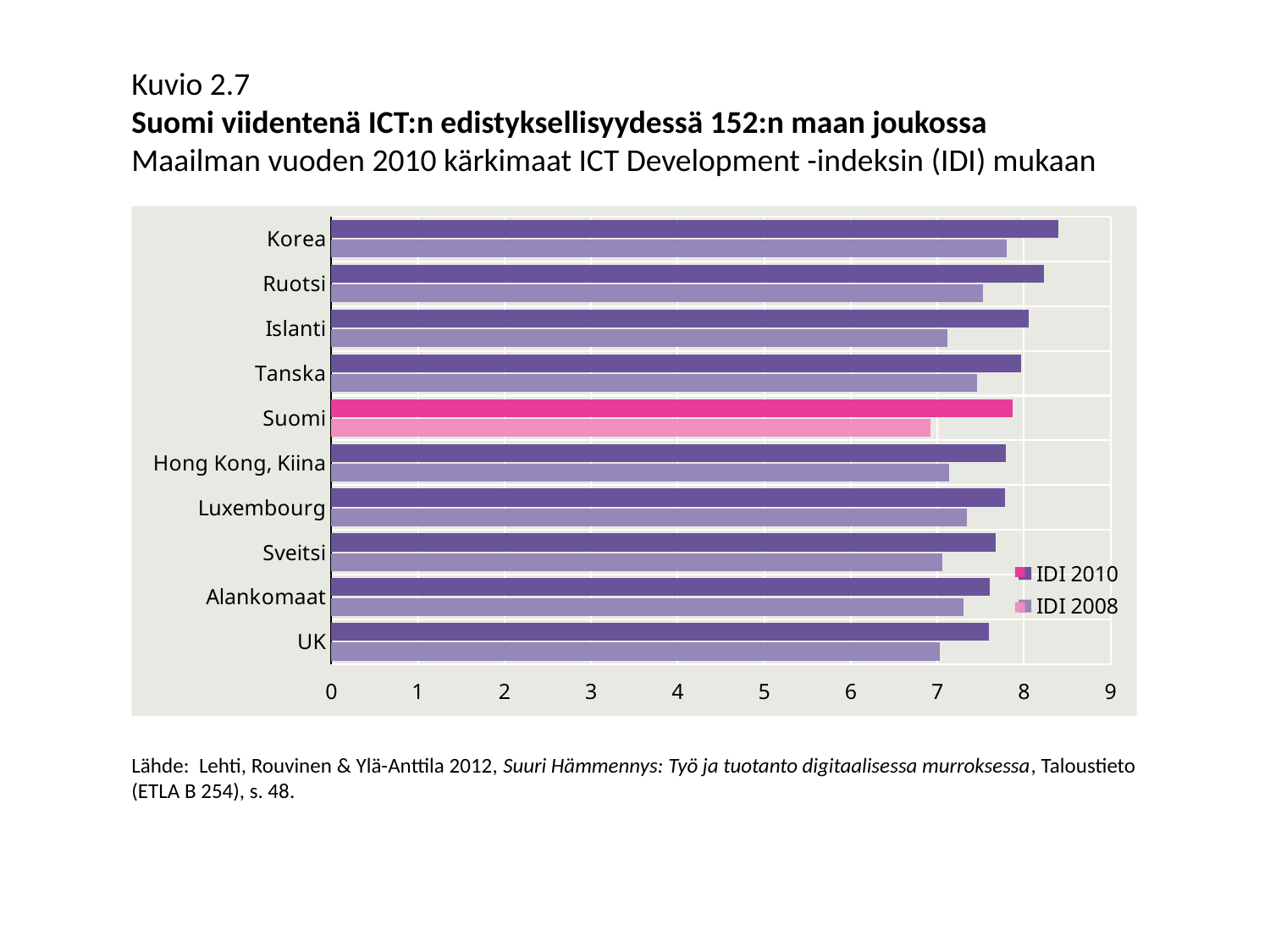
What are the two series named in the legend? IDI 2010 and IDI 2008 Is the IDI 2010 value for Korea greater or less than 8? greater Which country's bars are highlighted in pink instead of purple? Suomi How many countries are listed on the chart? 10 Is the IDI 2008 value for Korea greater or less than 7? greater Is the IDI 2008 value for Suomi greater or less than 7? less How many series does the legend list? 2 Which country has the lowest IDI 2008 value? Suomi What kind of chart is shown on the slide? Bar chart Which country has the highest IDI 2010 value? Korea Which is larger, the IDI 2010 value for Korea or the IDI 2010 value for UK? Korea